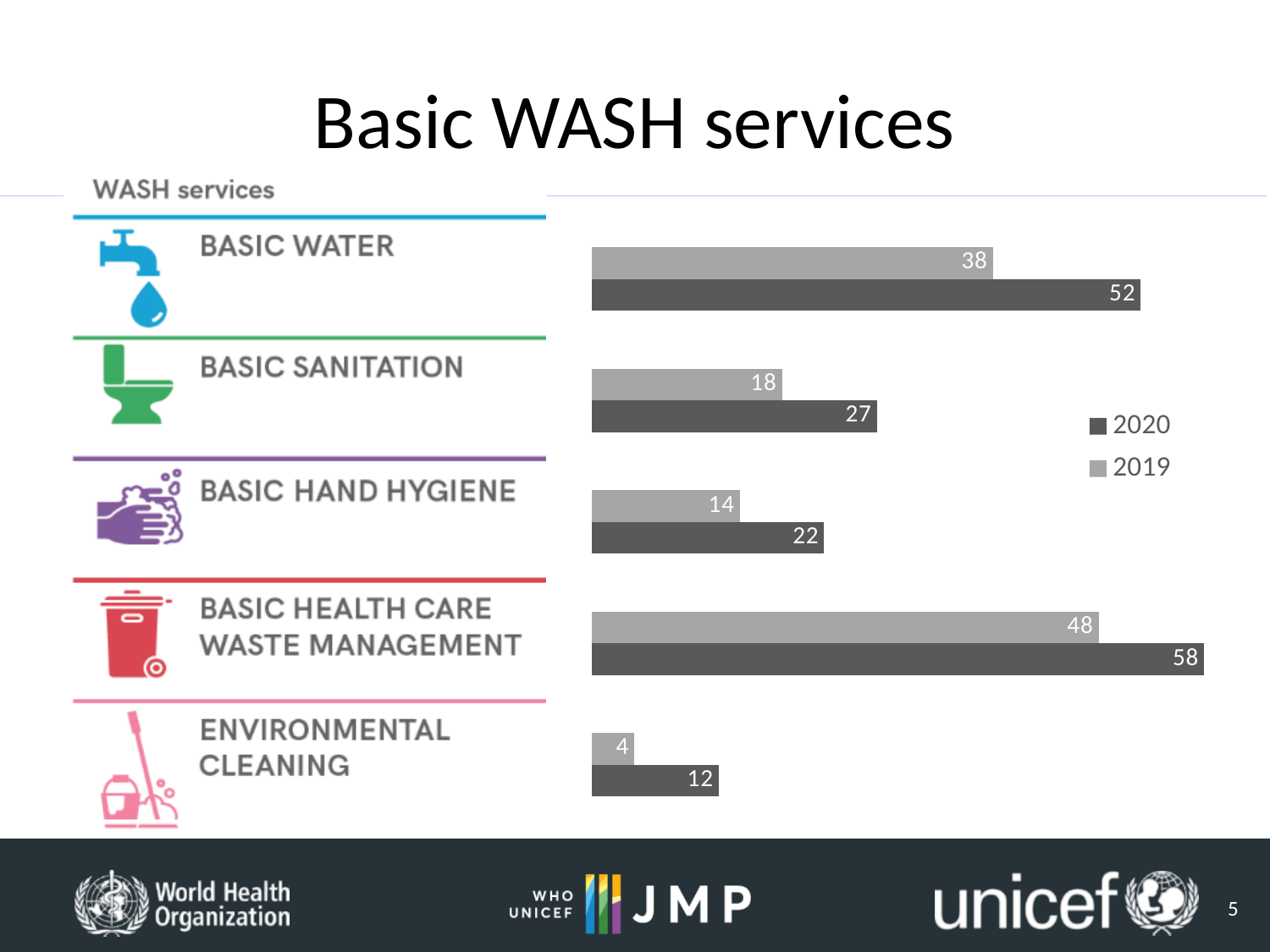
Which category has the highest 2020 value? Basic Health Care Waste Management What is the 2019 value for Basic Hand Hygiene? 14 What is the difference between the 2020 and 2019 values for Basic Health Care Waste Management? 10 What is the difference between the 2020 and 2019 values for Basic Water? 14 What is the 2020 value for Environmental Cleaning? 12 How many categories are shown in the chart? 5 What kind of chart is shown on the slide? Bar chart Which category has the lowest 2019 value? Environmental Cleaning How many series does the legend list? 2 What is the 2020 value for Basic Water? 52 What is the 2019 value for Basic Sanitation? 18 Which is larger: the 2020 value for Basic Sanitation or the 2020 value for Basic Hand Hygiene? Basic Sanitation